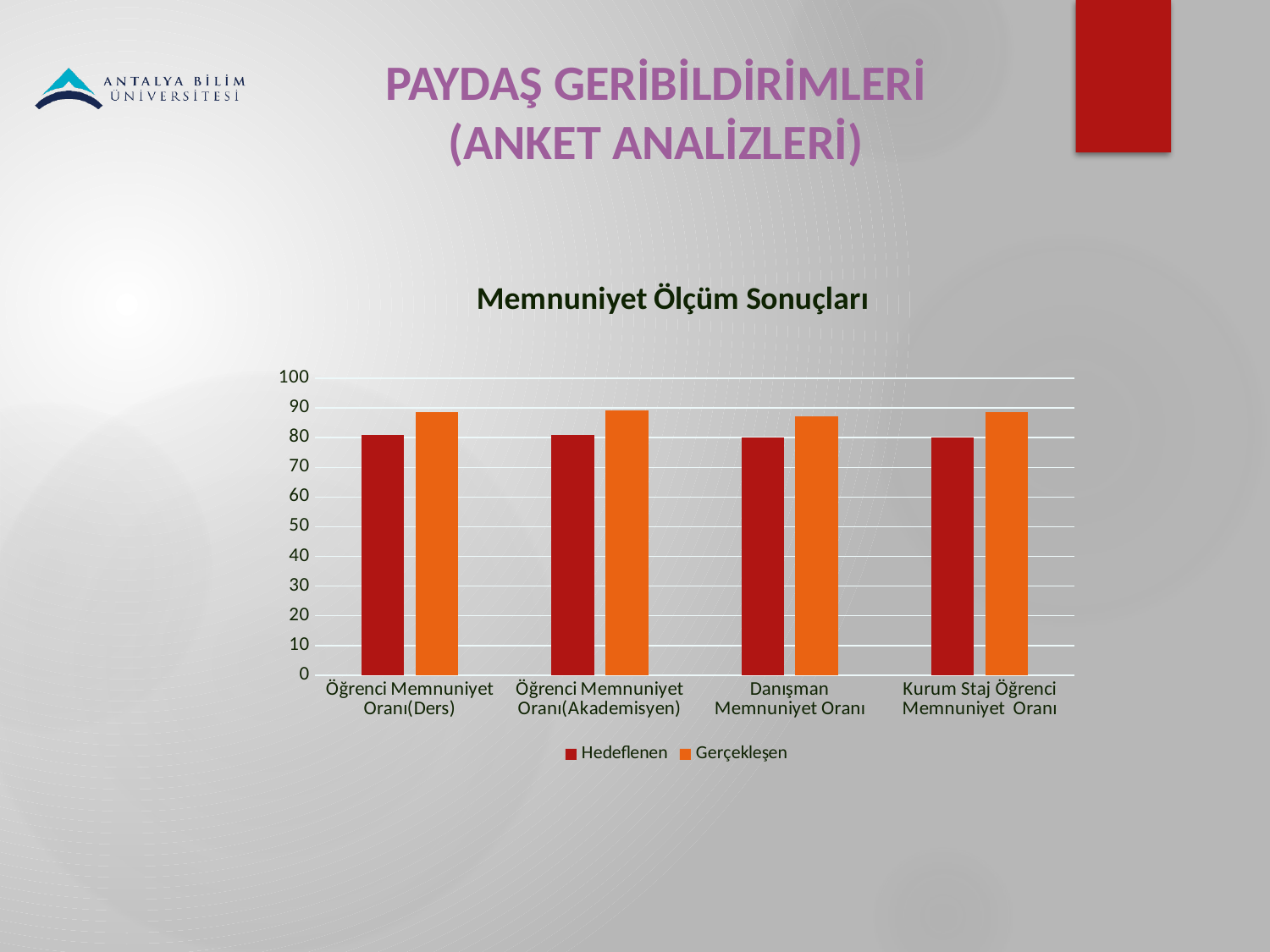
Is the Gerçekleşen value for Öğrenci Memnuniyet Oranı(Akademisyen) greater or less than 80? greater What kind of chart is shown on the slide? bar chart Is the Hedeflenen value for Öğrenci Memnuniyet Oranı(Ders) greater or less than 70? greater Is the Gerçekleşen value for Danışman Memnuniyet Oranı greater or less than 90? less How many categories are shown on the x axis? 4 For Kurum Staj Öğrenci Memnuniyet Oranı, which is larger: Hedeflenen or Gerçekleşen? Gerçekleşen For Öğrenci Memnuniyet Oranı(Ders), which is larger: Hedeflenen or Gerçekleşen? Gerçekleşen What is the title of the chart? Memnuniyet Ölçüm Sonuçları Which series is shown in orange in the legend? Gerçekleşen For Danışman Memnuniyet Oranı, which is larger: Hedeflenen or Gerçekleşen? Gerçekleşen How many series does the legend list? 2